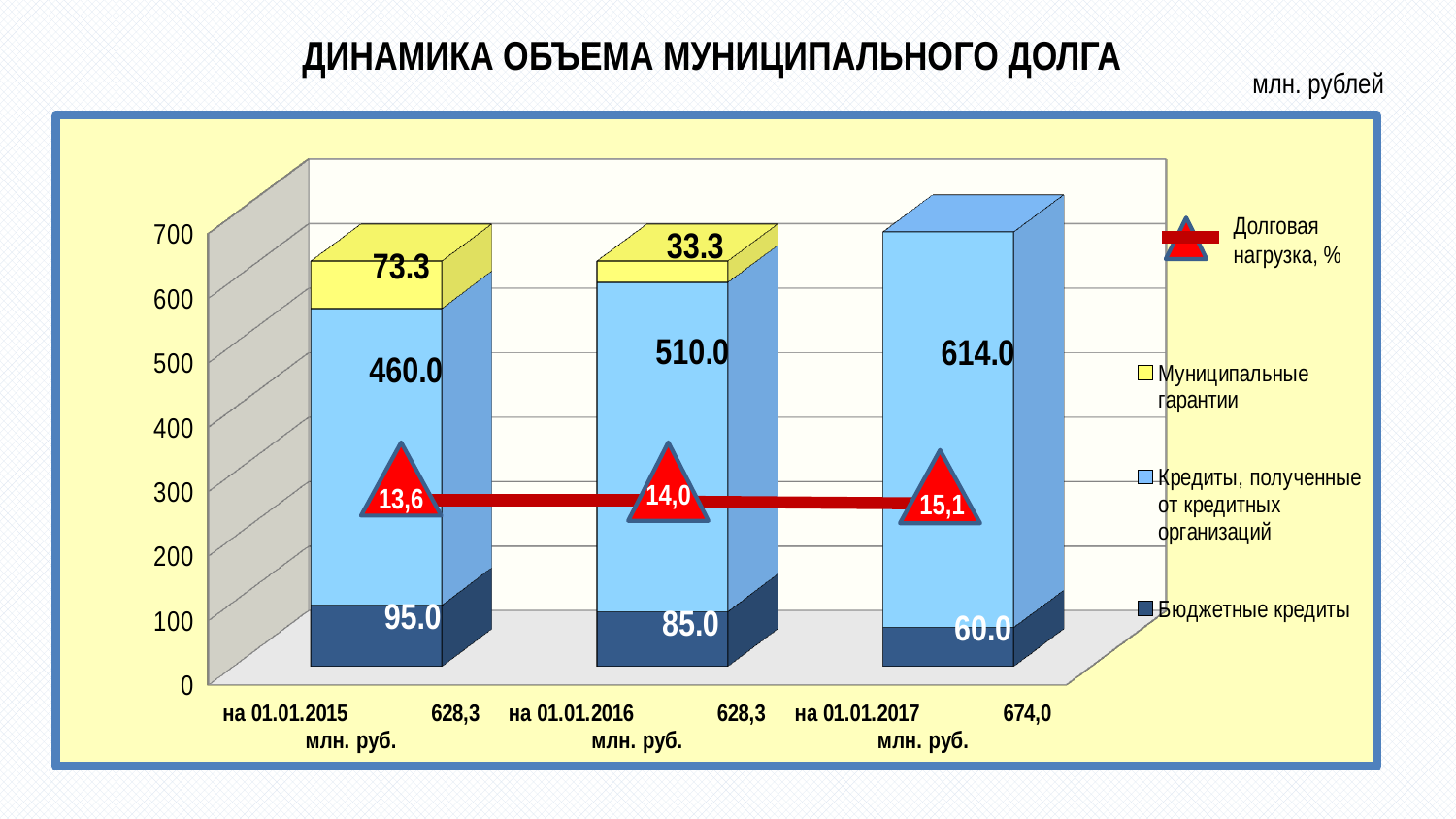
What is the difference between the Кредиты, полученные от кредитных организаций values on 01.01.2016 and 01.01.2015? 50.0 How many entries does the legend list? 4 What is the Долговая нагрузка, % value on 01.01.2017? 15,1 On which date is the value of Бюджетные кредиты the lowest? на 01.01.2017 What kind of chart is shown on the slide? Stacked bar chart with a line What is the value of Муниципальные гарантии on 01.01.2016? 33.3 Which is larger: Муниципальные гарантии on 01.01.2015 or on 01.01.2016? на 01.01.2015 How many dates (categories) are shown on the x axis? 3 On which date is the value of Кредиты, полученные от кредитных организаций the highest? на 01.01.2017 What is the value of Кредиты, полученные от кредитных организаций on 01.01.2017? 614.0 What is the value of Бюджетные кредиты on 01.01.2015? 95.0 What is the total municipal debt shown for 01.01.2017? 674,0 млн. руб.